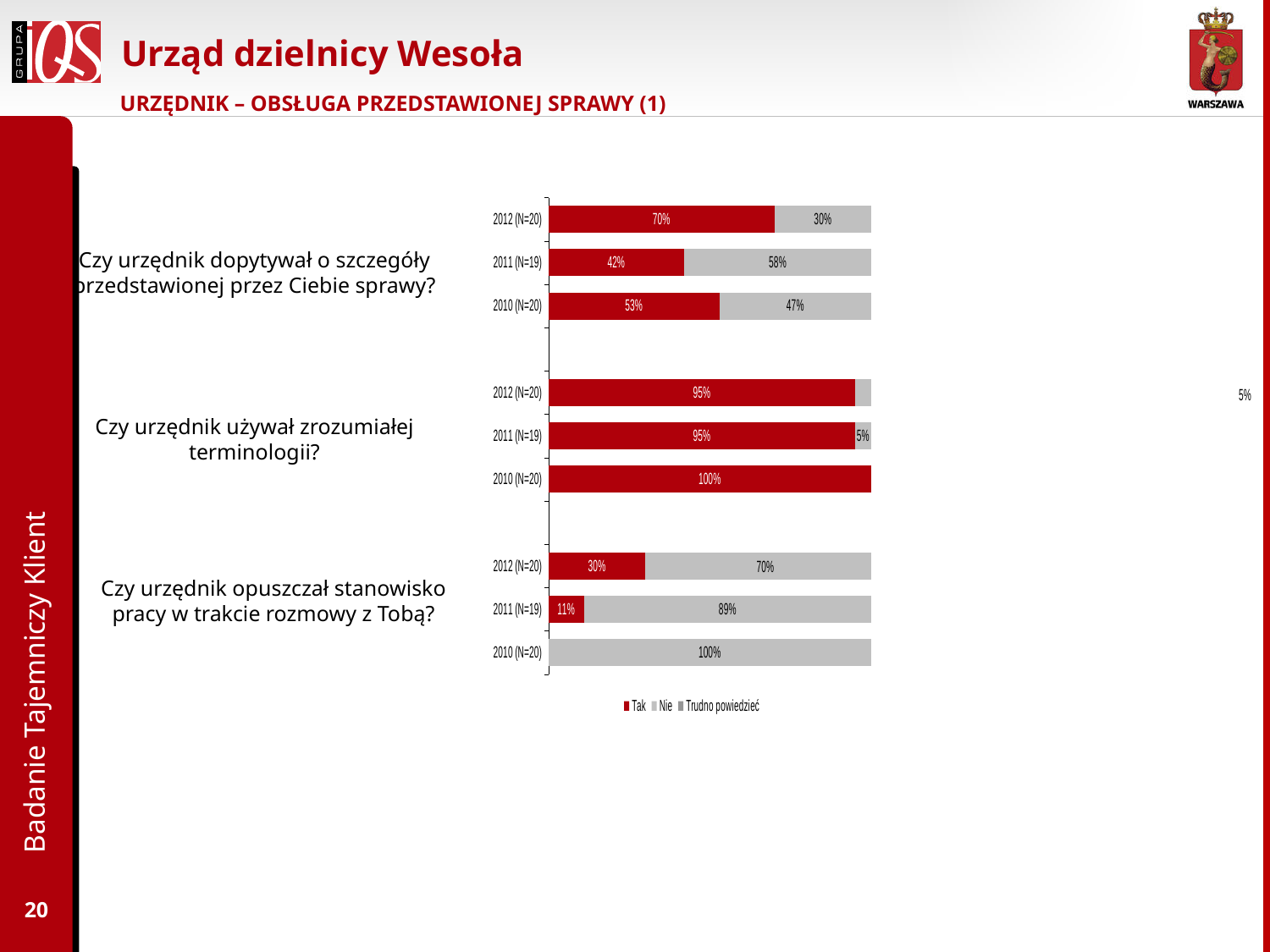
How many series does the chart legend list? 3 For the question "Czy urzędnik opuszczał stanowisko pracy w trakcie rozmowy z Tobą?", which is larger: the "Tak" value for 2012 (N=20) or for 2011 (N=19)? 2012 (N=20) For the question "Czy urzędnik opuszczał stanowisko pracy w trakcie rozmowy z Tobą?", which year has the lowest "Nie" share? 2012 (N=20) For the question "Czy urzędnik dopytywał o szczegóły przedstawionej przez Ciebie sprawy?", what is the "Nie" value for 2011 (N=19)? 58% How many bars (year rows) are plotted in the chart in total? 9 For the question "Czy urzędnik dopytywał o szczegóły przedstawionej przez Ciebie sprawy?", what is the difference in percentage points between the "Tak" values for 2012 (N=20) and 2011 (N=19)? 28 For the question "Czy urzędnik dopytywał o szczegóły przedstawionej przez Ciebie sprawy?", which year has the highest "Tak" share? 2012 (N=20) What kind of chart is shown on the slide? stacked bar chart For the question "Czy urzędnik dopytywał o szczegóły przedstawionej przez Ciebie sprawy?", what is the "Tak" value for 2012 (N=20)? 70% What are the legend entries of the chart? Tak, Nie, Trudno powiedzieć For the question "Czy urzędnik opuszczał stanowisko pracy w trakcie rozmowy z Tobą?", what is the "Tak" value for 2011 (N=19)? 11% For the question "Czy urzędnik używał zrozumiałej terminologii?", what is the "Tak" value for 2010 (N=20)? 100%